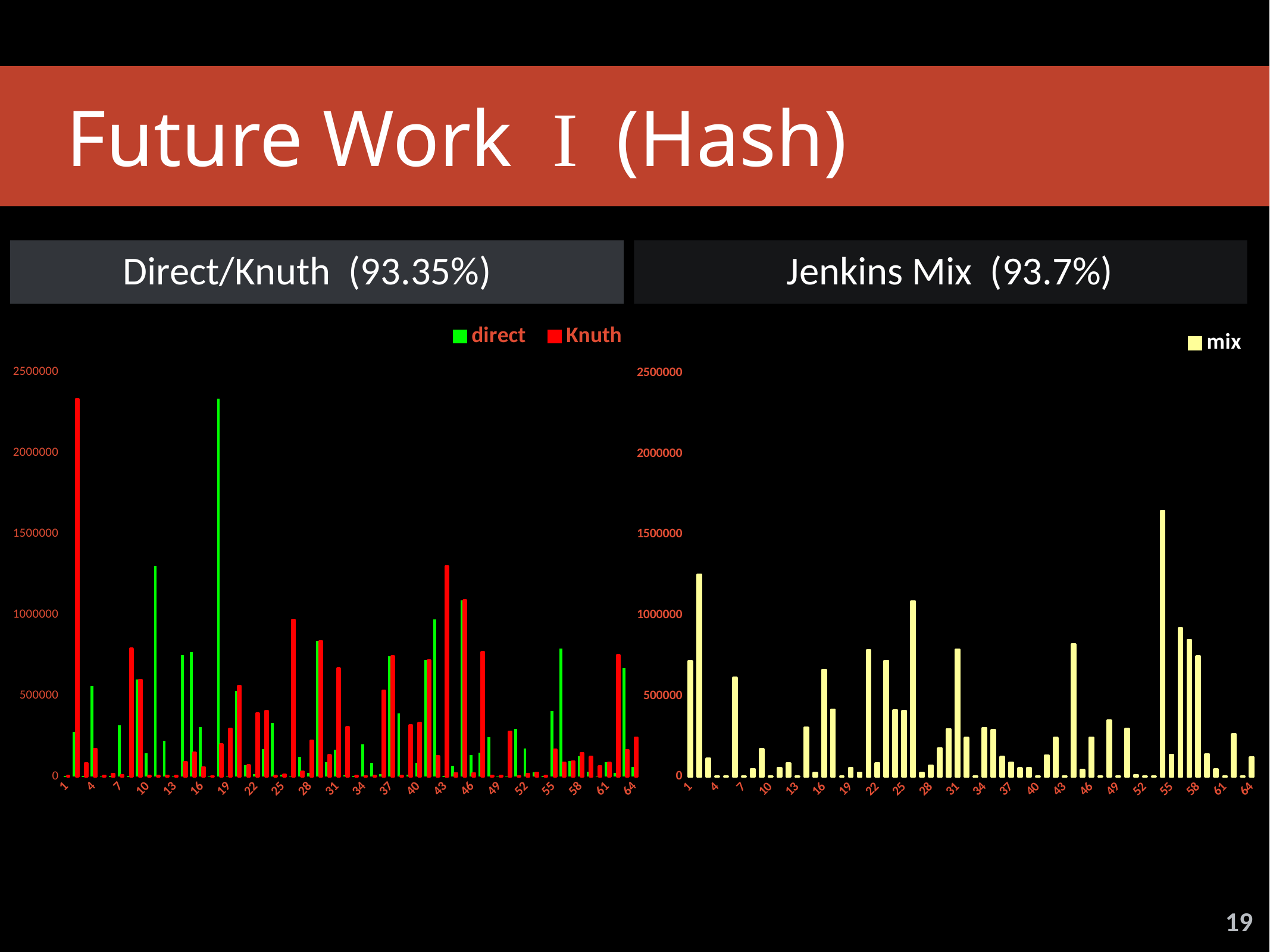
What kind of chart is the Direct/Knuth (93.35%) chart? bar chart In the Direct/Knuth (93.35%) chart, what are the names of the two series in the legend? direct and Knuth What kind of chart is the Jenkins Mix (93.7%) chart? bar chart In the Direct/Knuth (93.35%) chart, how many Knuth bars exceed 2000000? 1 How many series does the legend of the Jenkins Mix (93.7%) chart list? 1 In the Direct/Knuth (93.35%) chart, is the tallest Knuth bar greater or less than 2000000? greater How many series does the legend of the Direct/Knuth (93.35%) chart list? 2 In the Jenkins Mix (93.7%) chart, is the tallest mix bar greater or less than 1500000? greater In the Direct/Knuth (93.35%) chart, what is the highest value shown on the vertical axis? 2500000 In the Direct/Knuth (93.35%) chart, is the tallest direct bar greater or less than 2000000? greater In the Jenkins Mix (93.7%) chart, how many mix bars exceed 1500000? 1